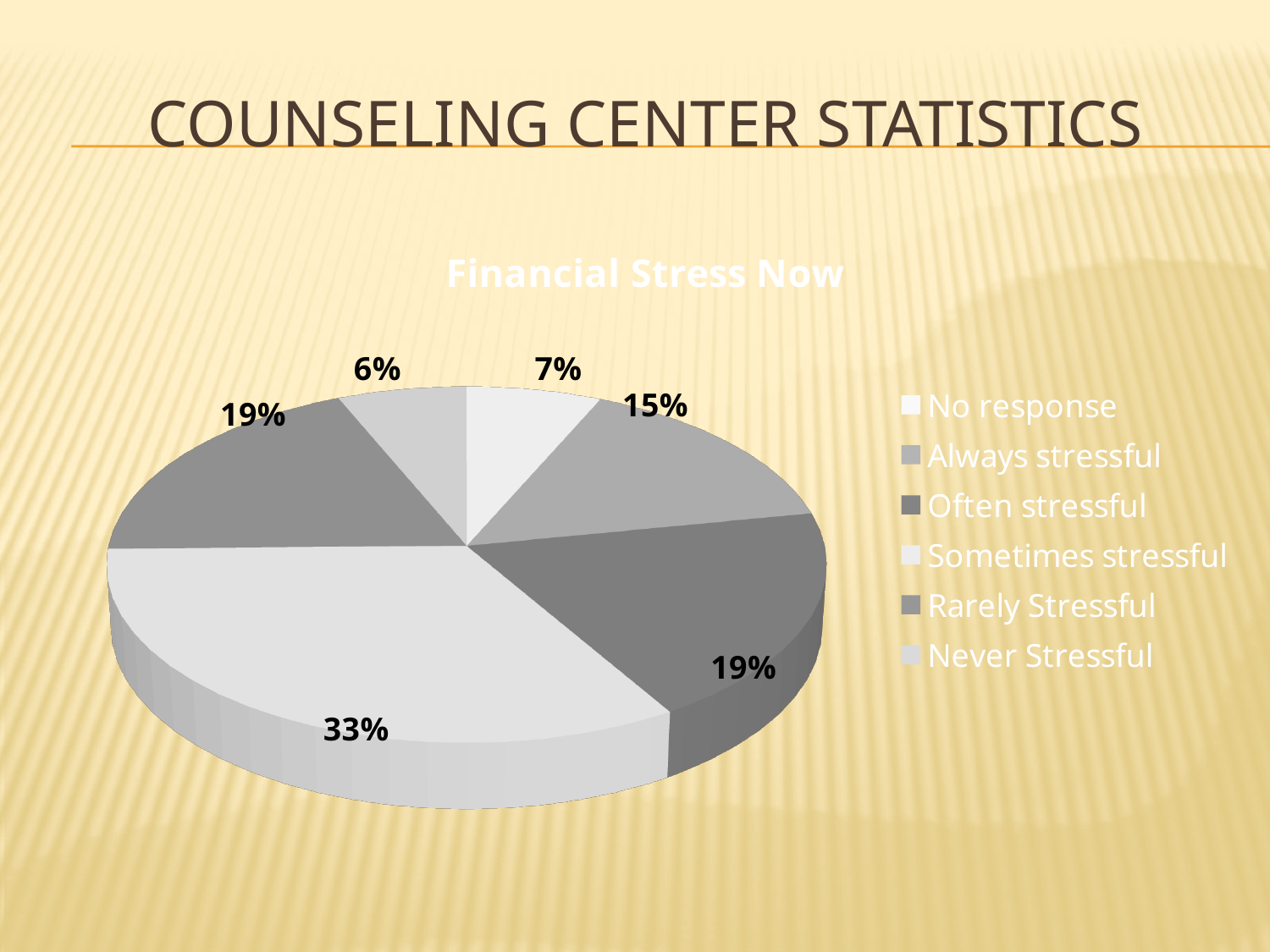
Which category has the largest share of the pie? Sometimes stressful What kind of chart is shown on the slide? pie chart What is the combined share of 'Often stressful' and 'Rarely Stressful'? 38% What percentage of the pie is 'Always stressful'? 15% What percentage of the pie is 'No response'? 7% How many categories does the legend list? 6 What percentage of the pie is 'Sometimes stressful'? 33% What percentage of the pie is 'Never Stressful'? 6% Which category has the smallest share of the pie? Never Stressful What is the title of the chart? Financial Stress Now Which is larger, the share for 'Always stressful' or the share for 'No response'? Always stressful What is the difference in percentage points between 'Sometimes stressful' and 'Always stressful'? 18